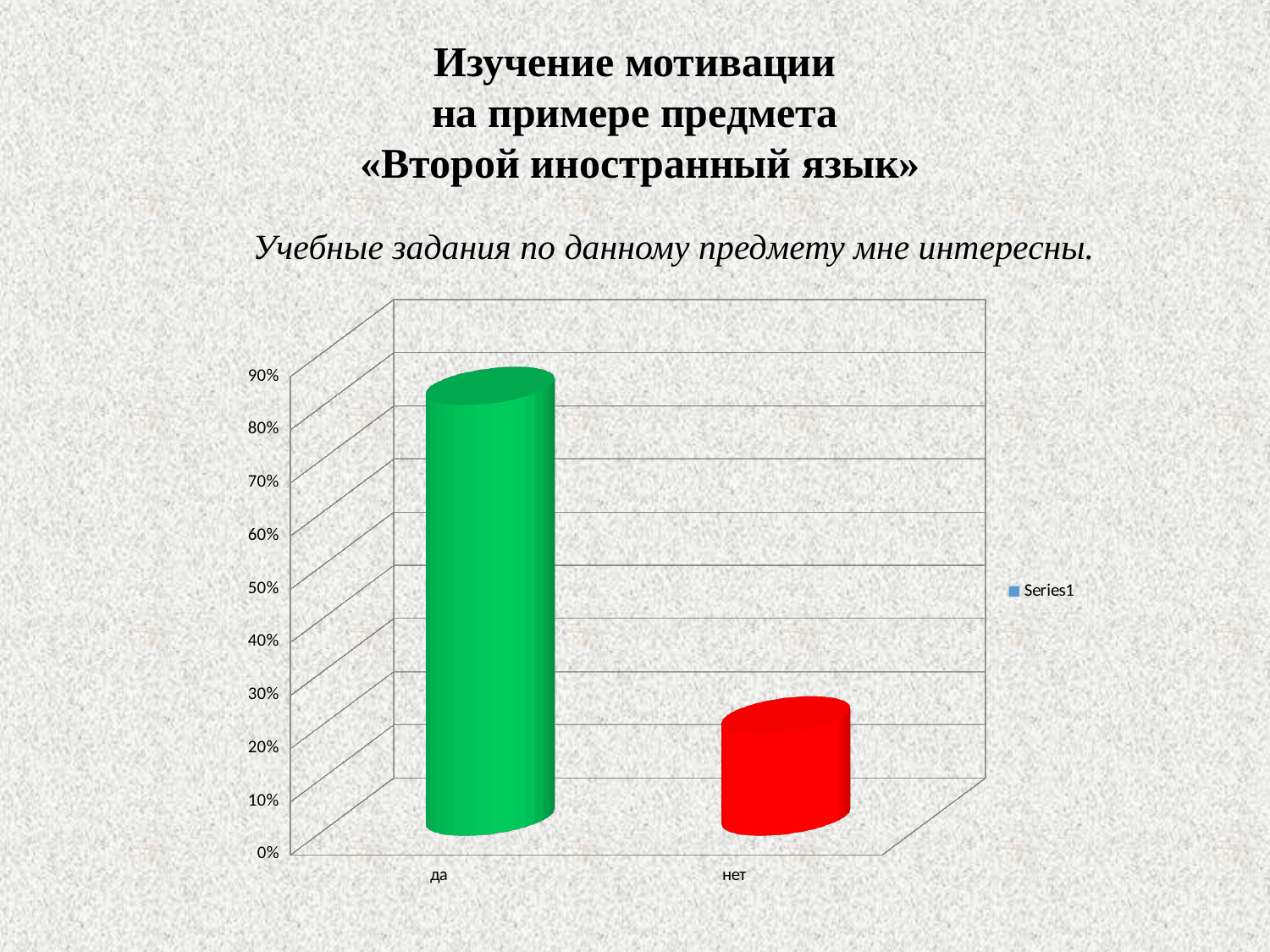
How many series does the chart legend list? 1 Which is larger, the value for да or the value for нет? да Is the value for да greater or less than 60%? greater Is the value for нет greater or less than 50%? less How many categories are shown on the x axis of the chart? 2 What is the name of the series listed in the chart legend? Series1 Which category has the lowest value in the chart? нет Is the value for да greater or less than 50%? greater What colour is the bar for the category нет? red What kind of chart is shown on the slide? bar chart Which category has the highest value in the chart? да